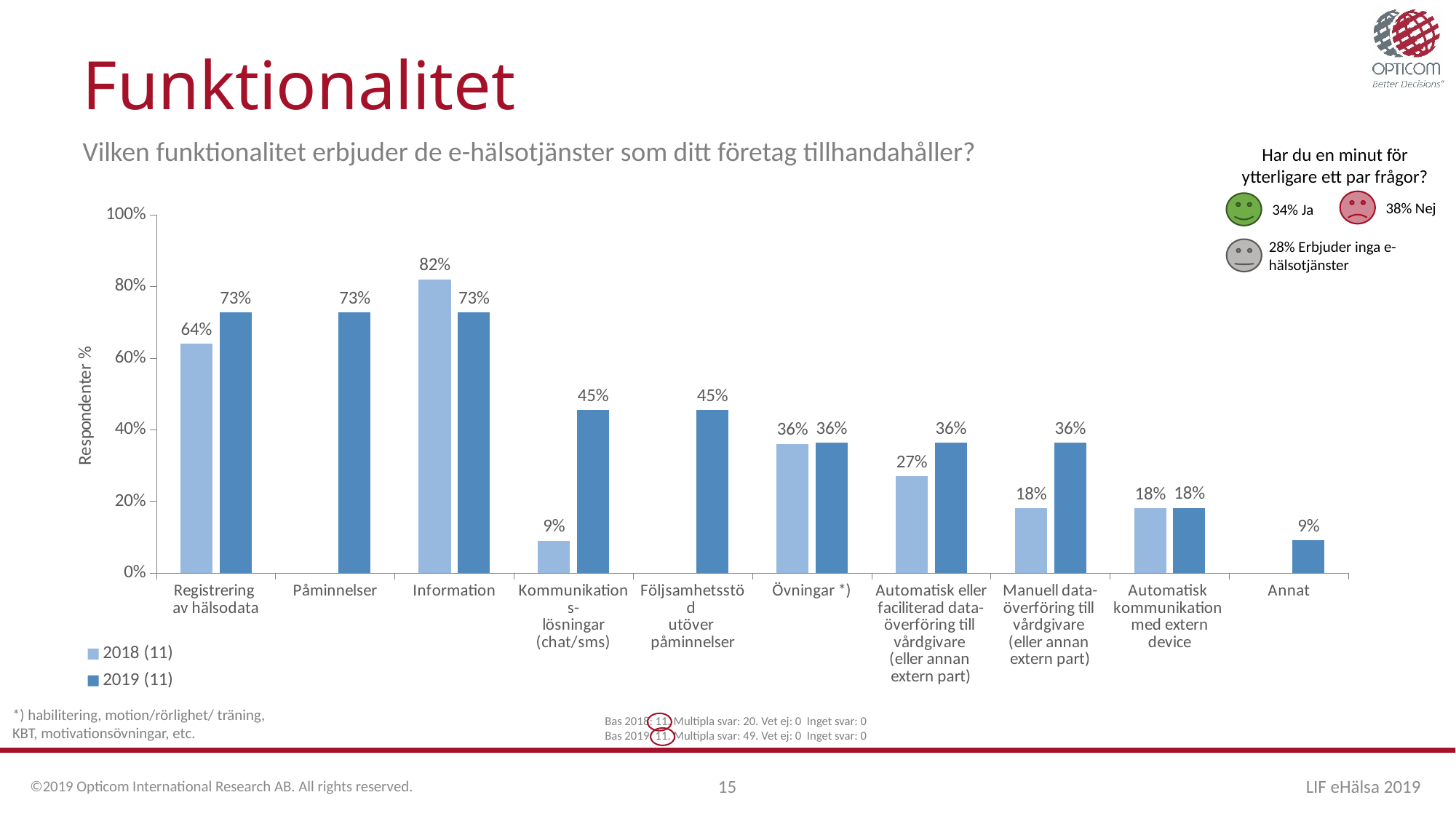
What is the difference between the 2019 and 2018 values for Manuell data-överföring till vårdgivare? 18% How many series does the chart legend list? 2 How many categories are shown on the x axis of the chart? 10 What is the 2018 value for Information? 82% Which is larger for Registrering av hälsodata, the 2018 value or the 2019 value? 2019 What is the 2019 value for Annat? 9% What is the y-axis label of the chart? Respondenter % Which category has the lowest 2019 value? Annat What kind of chart is shown on the slide? Bar chart What is the 2019 value for Kommunikationslösningar (chat/sms)? 45% Is the 2019 value for Påminnelser greater or less than 60%? greater Which category has the highest 2018 value? Information